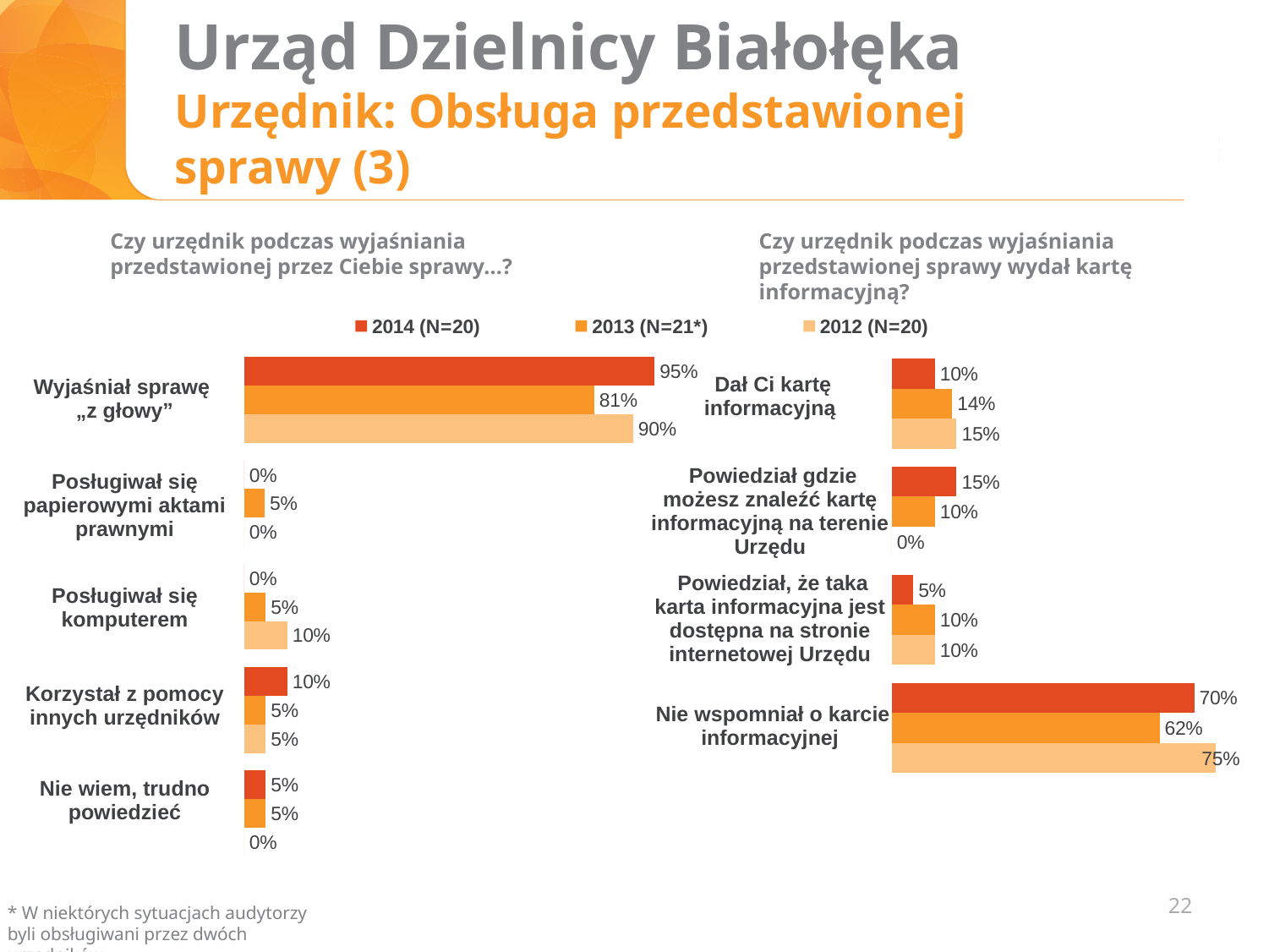
In the right chart ("Czy urzędnik podczas wyjaśniania przedstawionej sprawy wydał kartę informacyjną?"), what is the 2013 value for "Nie wspomniał o karcie informacyjnej"? 62% In the right chart, what is the difference between the 2012 and 2013 values for "Nie wspomniał o karcie informacyjnej"? 13 percentage points In the left chart, what is the difference between the 2014 and 2013 values for "Wyjaśniał sprawę „z głowy”"? 14 percentage points How many series does the legend list? 3 In the left chart, what is the 2012 value for "Posługiwał się komputerem"? 10% In the right chart, what is the 2012 value for "Dał Ci kartę informacyjną"? 15% In the left chart, what is the 2013 value for "Wyjaśniał sprawę „z głowy”"? 81% In the left chart, how many categories are shown? 5 In the right chart, which is larger for "Nie wspomniał o karcie informacyjnej": the 2014 value or the 2012 value? 2012 In the right chart, which category has the highest 2014 value? Nie wspomniał o karcie informacyjnej What type of chart is used on this slide? Bar chart In the left chart ("Czy urzędnik podczas wyjaśniania przedstawionej przez Ciebie sprawy...?"), what is the 2014 value for "Wyjaśniał sprawę „z głowy”"? 95%